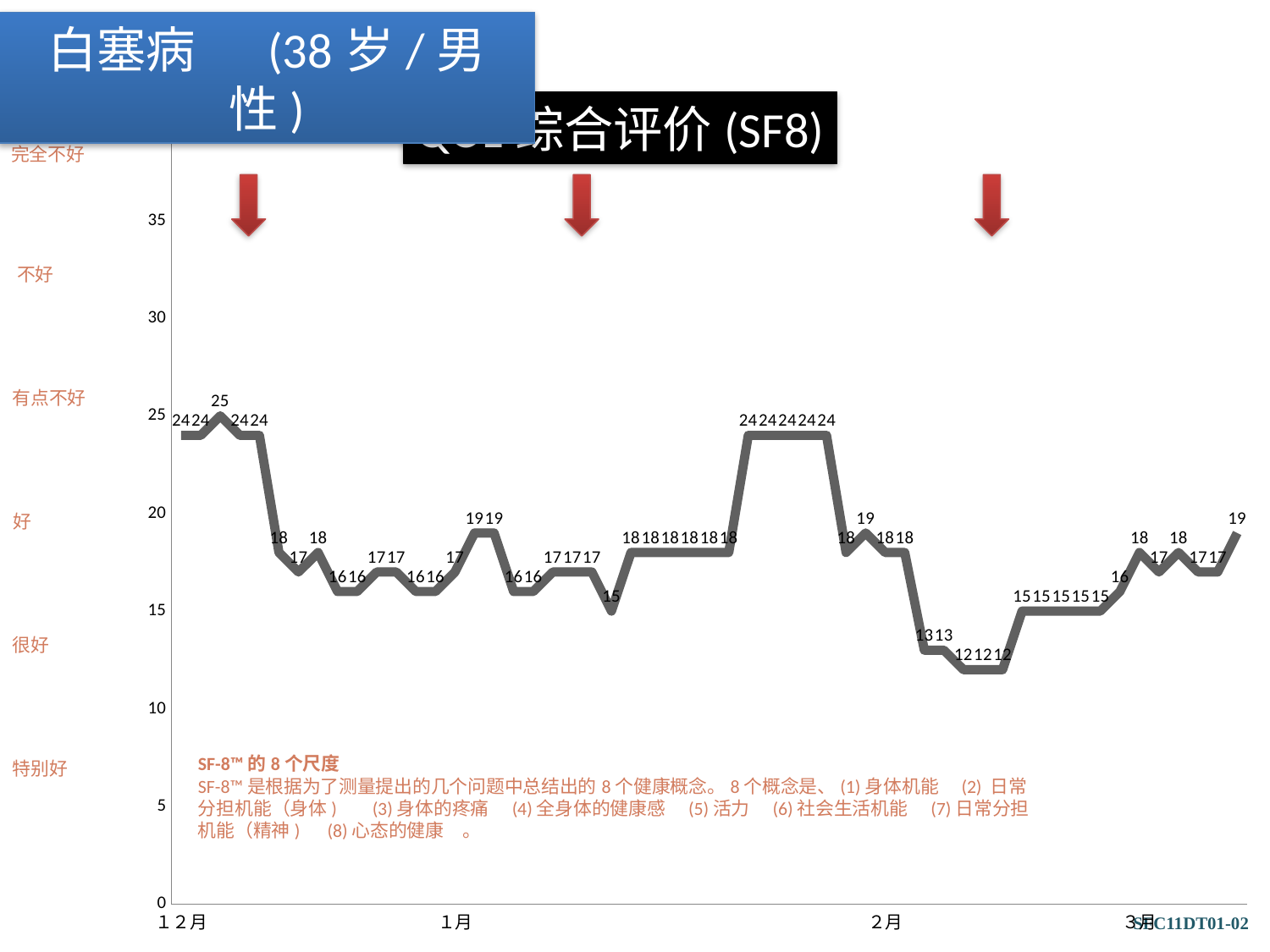
What is the lowest value printed on the line chart? 12 Comparing the first data point to the last data point, does the value rise or fall? fall How many month labels are shown on the x axis? 4 Is the lowest value on the chart greater or less than 10? greater Is the highest value on the chart greater or less than 30? less How many consecutive data points have the value 12? 3 What is the value of the first data point on the chart (at 12月)? 24 What is the value of the last data point on the chart (at 3月)? 19 What is the highest value printed on the line chart? 25 What kind of chart is shown on the slide? line chart What is the difference between the highest and lowest values printed on the chart? 13 What text label appears at the top of the y axis, above 35? 完全不好